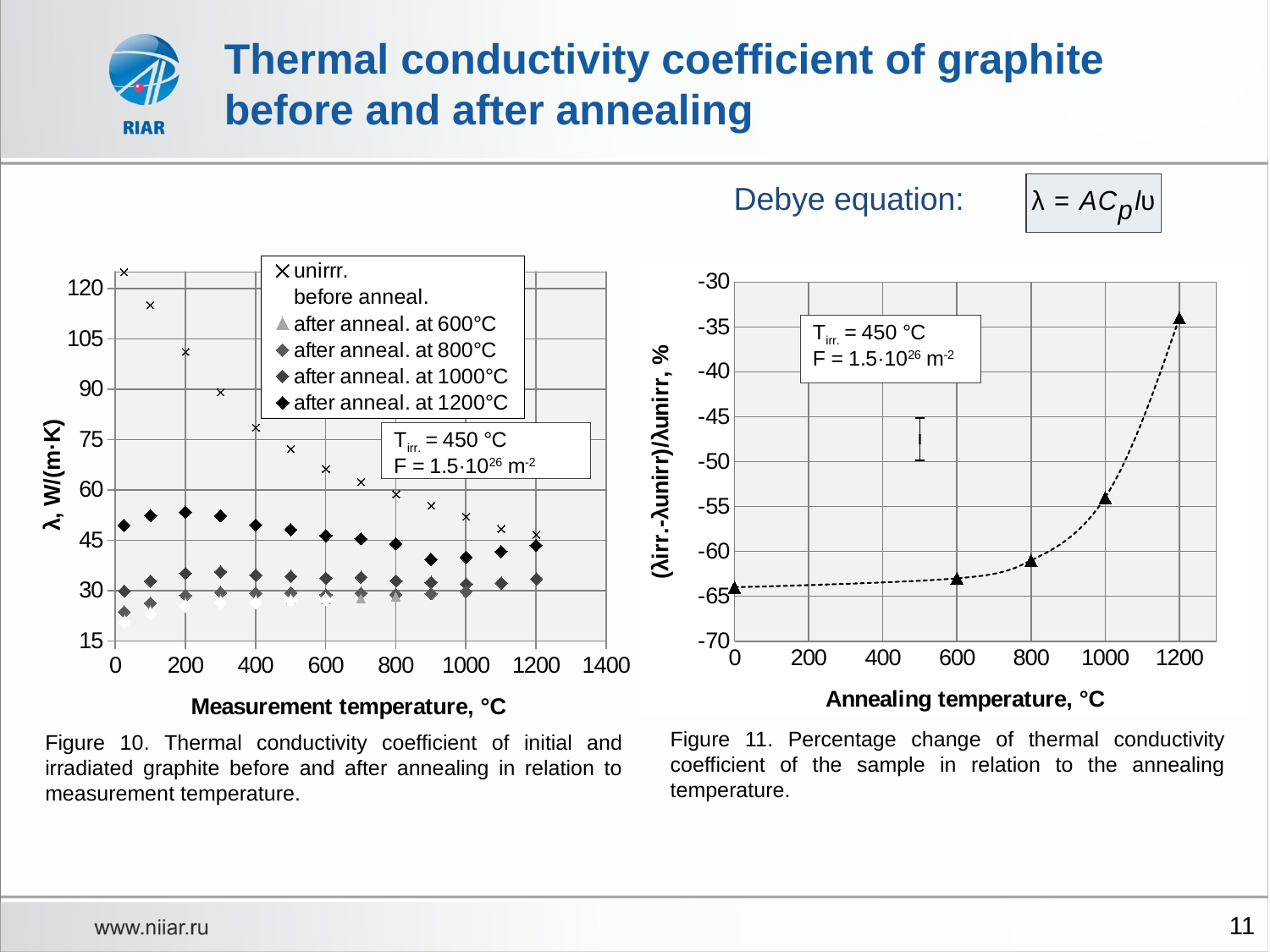
In Figure 11 (right chart), do the values rise or fall as annealing temperature increases? rise In Figure 11 (right chart), which is larger: the value at 1000 °C or the value at 1200 °C? 1200 °C What kind of chart is Figure 10 on the left of the slide? scatter chart In Figure 11 (right chart), is the value at an annealing temperature of 1200 °C greater or less than -40? greater How many data points are plotted in Figure 11 (right chart)? 5 What is the x-axis title of Figure 11 (right chart)? Annealing temperature, °C In Figure 10 (left chart), is the unirradiated (unirrr.) value at a measurement temperature of 1000 °C greater or less than 45? greater What is the y-axis title of Figure 10 (left chart)? λ, W/(m·K) In Figure 11 (right chart), is the value at an annealing temperature of 0 °C greater or less than -60? less In Figure 11 (right chart), at which annealing temperature is the plotted value highest? 1200 °C How many series does the legend of Figure 10 (left chart) list? 6